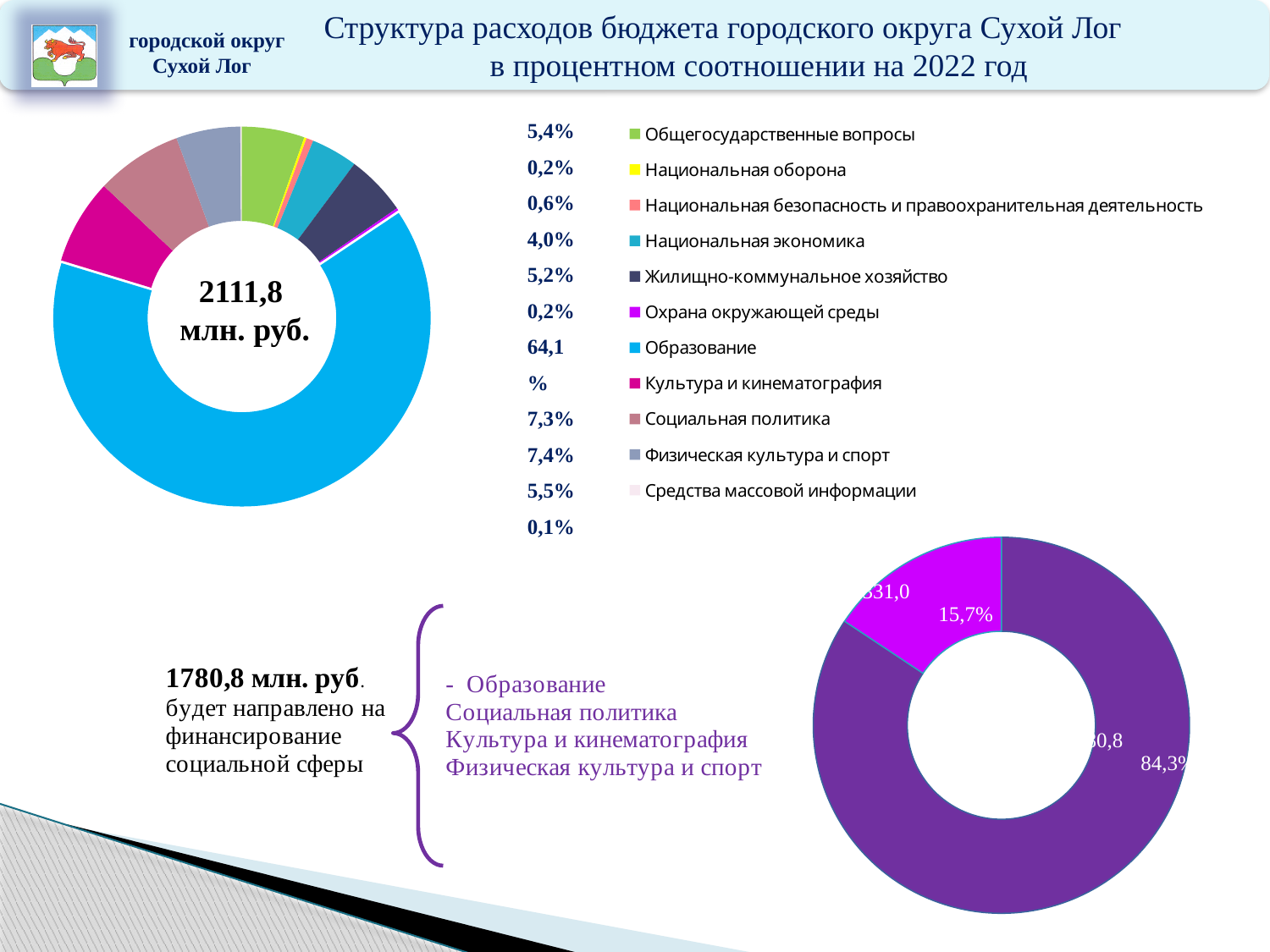
What kind of chart is the top-left chart on the slide? pie chart (donut) In the bottom-right chart, what percentage is shown on the larger (purple) slice? 84,3% How many categories does the legend of the top-left chart list? 11 In the top-left chart, what is the share for Жилищно-коммунальное хозяйство? 5,2% In the top-left chart, which is larger: Национальная экономика or Жилищно-коммунальное хозяйство? Жилищно-коммунальное хозяйство In the bottom-right chart, what percentage is shown on the smaller (magenta) slice? 15,7% In the top-left chart, what total amount is printed in the centre of the donut? 2111,8 млн. руб. In the top-left chart, what is the share for Общегосударственные вопросы? 5,4% In the top-left chart, what is the share for Национальная безопасность и правоохранительная деятельность? 0,6% How many slices does the bottom-right chart have? 2 In the top-left chart, which category has the largest slice? Образование In the top-left chart, what is the share for Национальная экономика? 4,0%